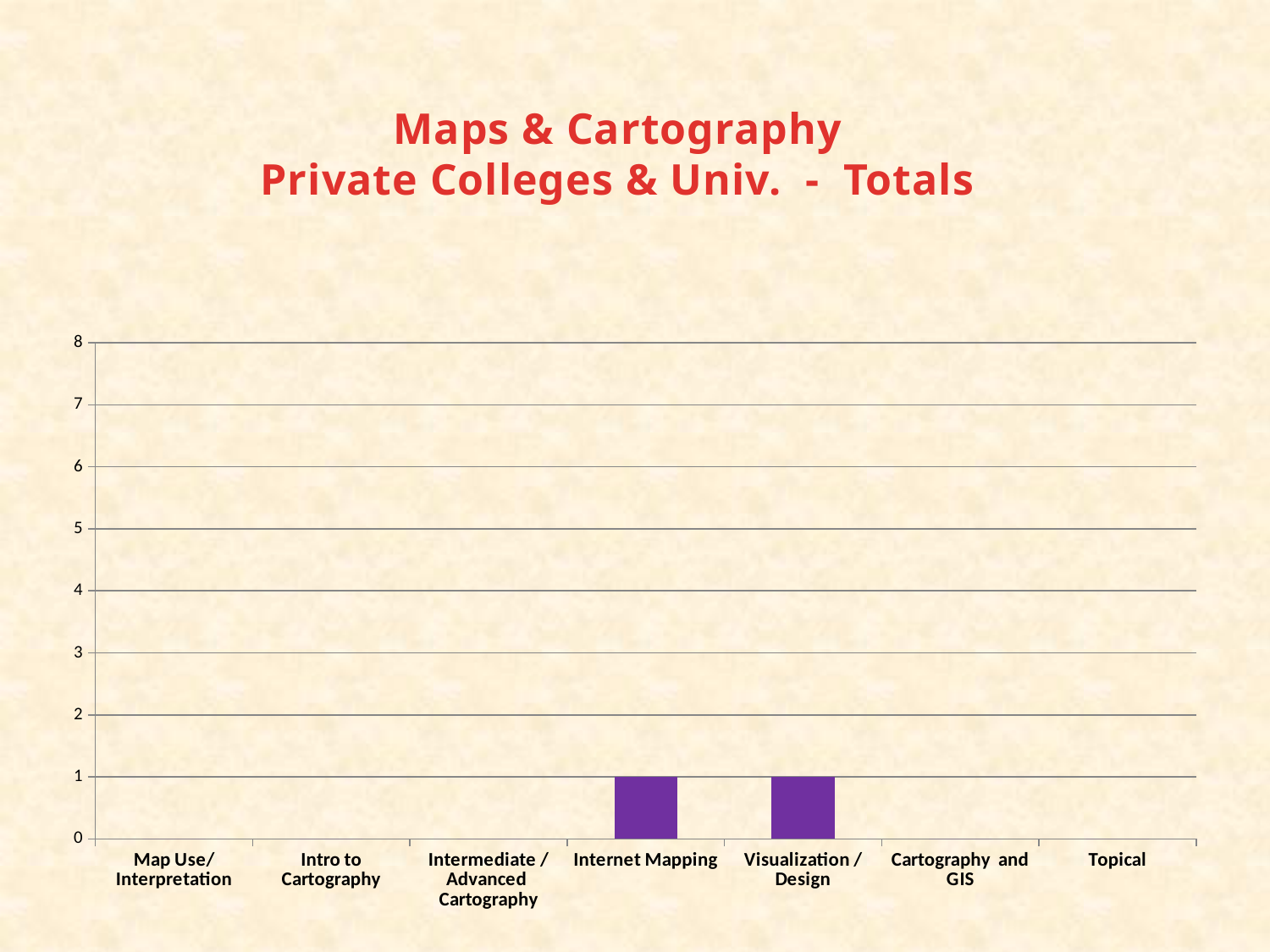
What is the difference between the value for Visualization / Design and the value for Map Use/ Interpretation? 1 What is the value for Visualization / Design? 1 Is the value for Internet Mapping greater or less than 4? less How many categories have a value greater than 0? 2 What kind of chart is shown on the slide? bar chart Which is larger, the value for Internet Mapping or the value for Cartography and GIS? Internet Mapping How many categories are shown on the x axis of the chart? 7 What is the title of the chart on the slide? Maps & Cartography Private Colleges & Univ. - Totals What is the value for Topical? 0 What is the value for Internet Mapping? 1 What is the highest value shown on the vertical axis of the chart? 8 What is the value for Intro to Cartography? 0